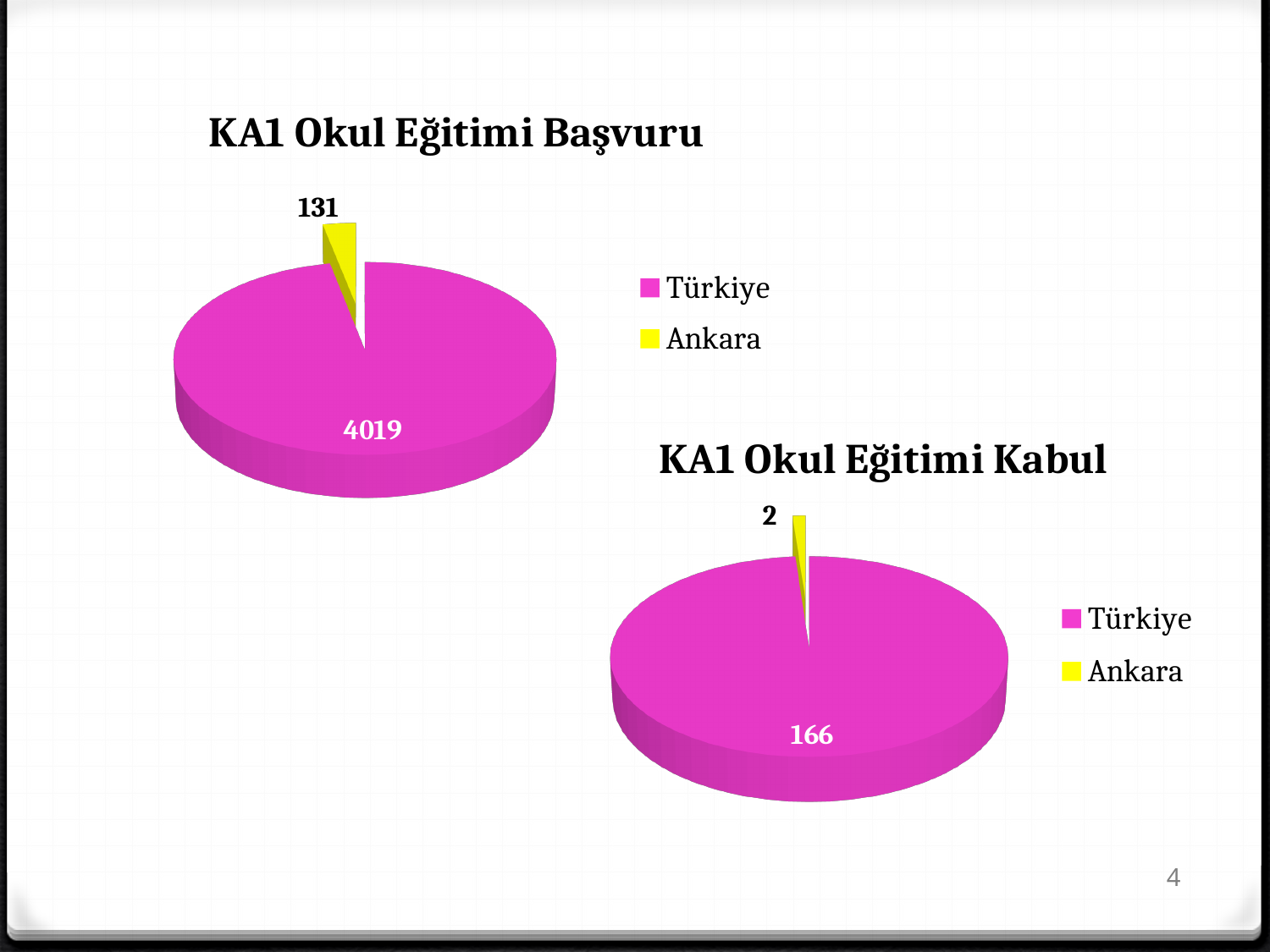
In the 'KA1 Okul Eğitimi Kabul' chart, what is the difference between the Türkiye and Ankara values? 164 What type of chart is the 'KA1 Okul Eğitimi Başvuru' chart? Pie chart In the 'KA1 Okul Eğitimi Kabul' chart, what is the value for Türkiye? 166 How many categories does the 'KA1 Okul Eğitimi Kabul' chart show? 2 In the 'KA1 Okul Eğitimi Kabul' chart, which colour represents Ankara? Yellow In the 'KA1 Okul Eğitimi Başvuru' chart, which category has the largest slice? Türkiye Is the Türkiye value larger in the 'KA1 Okul Eğitimi Başvuru' chart or in the 'KA1 Okul Eğitimi Kabul' chart? KA1 Okul Eğitimi Başvuru In the 'KA1 Okul Eğitimi Kabul' chart, what is the value for Ankara? 2 In the 'KA1 Okul Eğitimi Başvuru' chart, what is the value for Türkiye? 4019 In the 'KA1 Okul Eğitimi Başvuru' chart, what is the value for Ankara? 131 In the 'KA1 Okul Eğitimi Başvuru' chart, what is the difference between the Türkiye and Ankara values? 3888 In the 'KA1 Okul Eğitimi Kabul' chart, which category has the smallest slice? Ankara